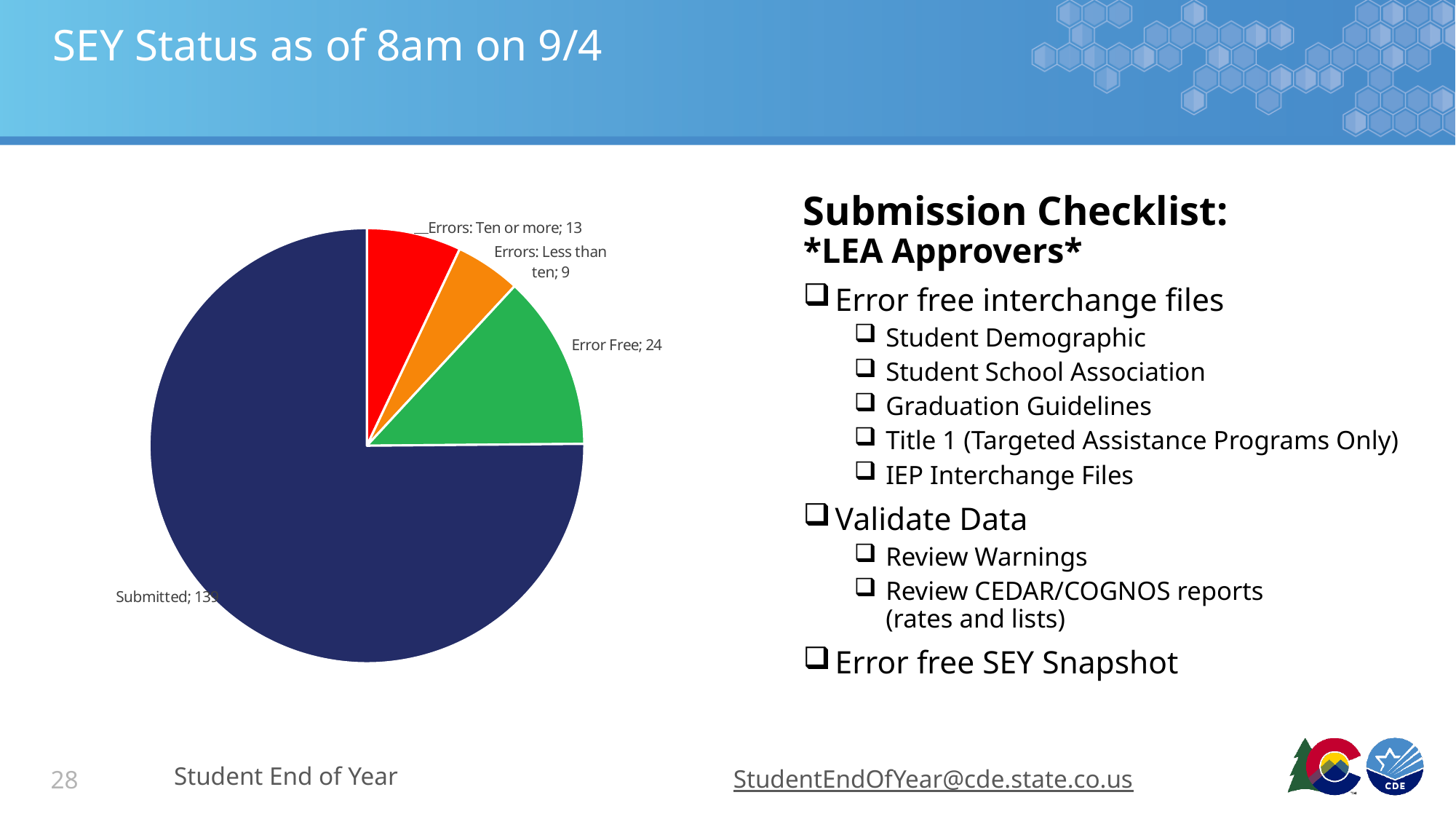
Which category has the smallest slice of the pie? Errors: Less than ten Which is larger, Error Free or 'Errors: Ten or more'? Error Free What is the value for the Error Free slice? 24 How many slices does the pie chart have? 4 Which category has the largest slice of the pie? Submitted What is the value for the 'Errors: Less than ten' slice? 9 What is the difference between the 'Errors: Ten or more' value and the 'Errors: Less than ten' value? 4 Which is larger, Submitted or Error Free? Submitted What kind of chart is shown on the slide? Pie chart What is the difference between the Error Free value and the 'Errors: Ten or more' value? 11 What is the value for the 'Errors: Ten or more' slice? 13 What colour is the Error Free slice? Green